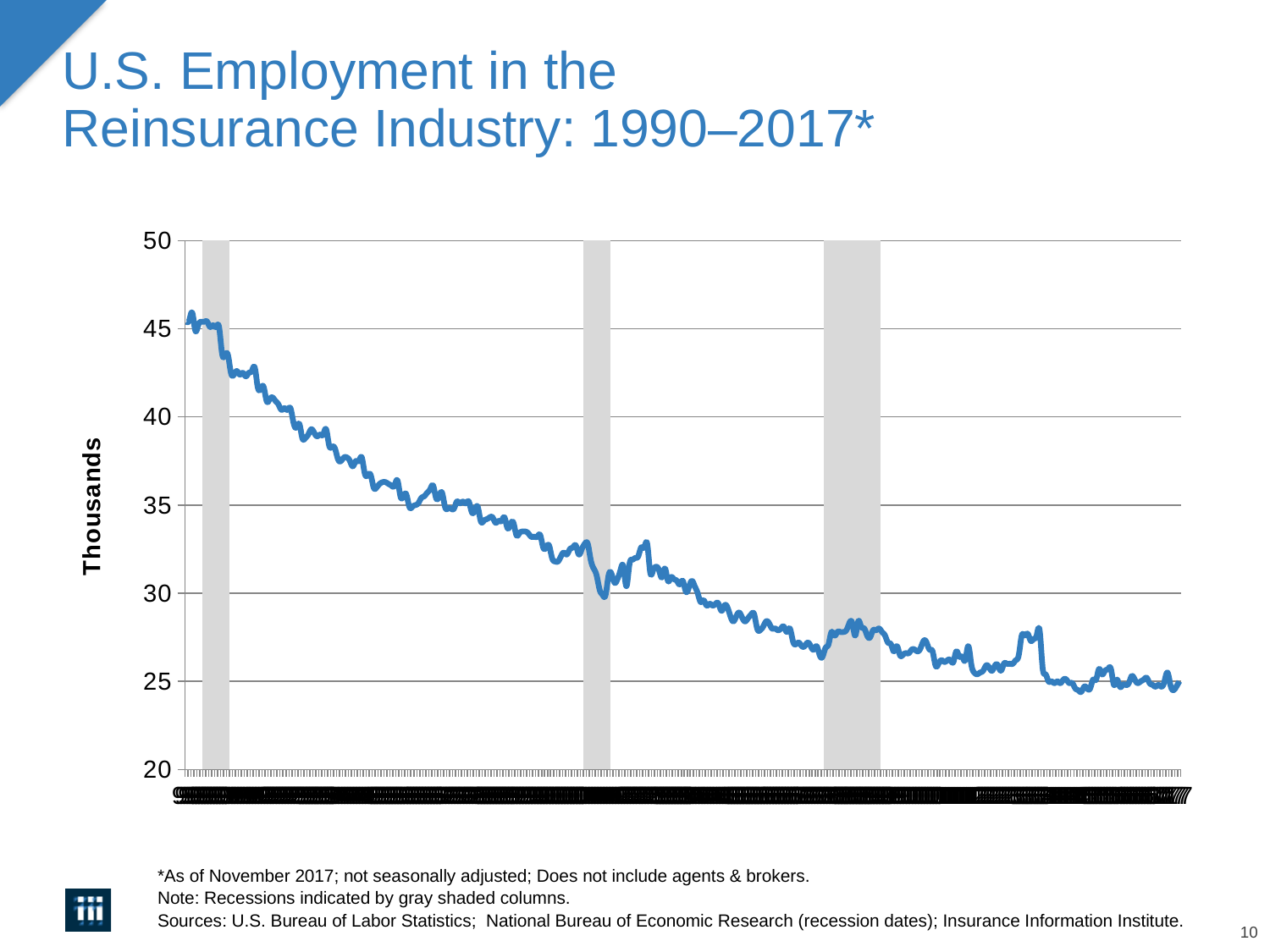
What is the title of the chart on the slide? U.S. Employment in the Reinsurance Industry: 1990–2017* Is the highest point of the line greater or less than 50? less How many gray shaded columns (recessions) are shown on the chart? 3 Is the value at the end of the series greater or less than 35? less What kind of chart is shown on the slide? line chart Is the value at the end of the series (right end of the line) greater or less than 30? less What is the label on the vertical axis of the chart? Thousands What is the highest value shown on the vertical axis? 50 Do the values in the chart generally rise or fall from left to right along the x axis? fall